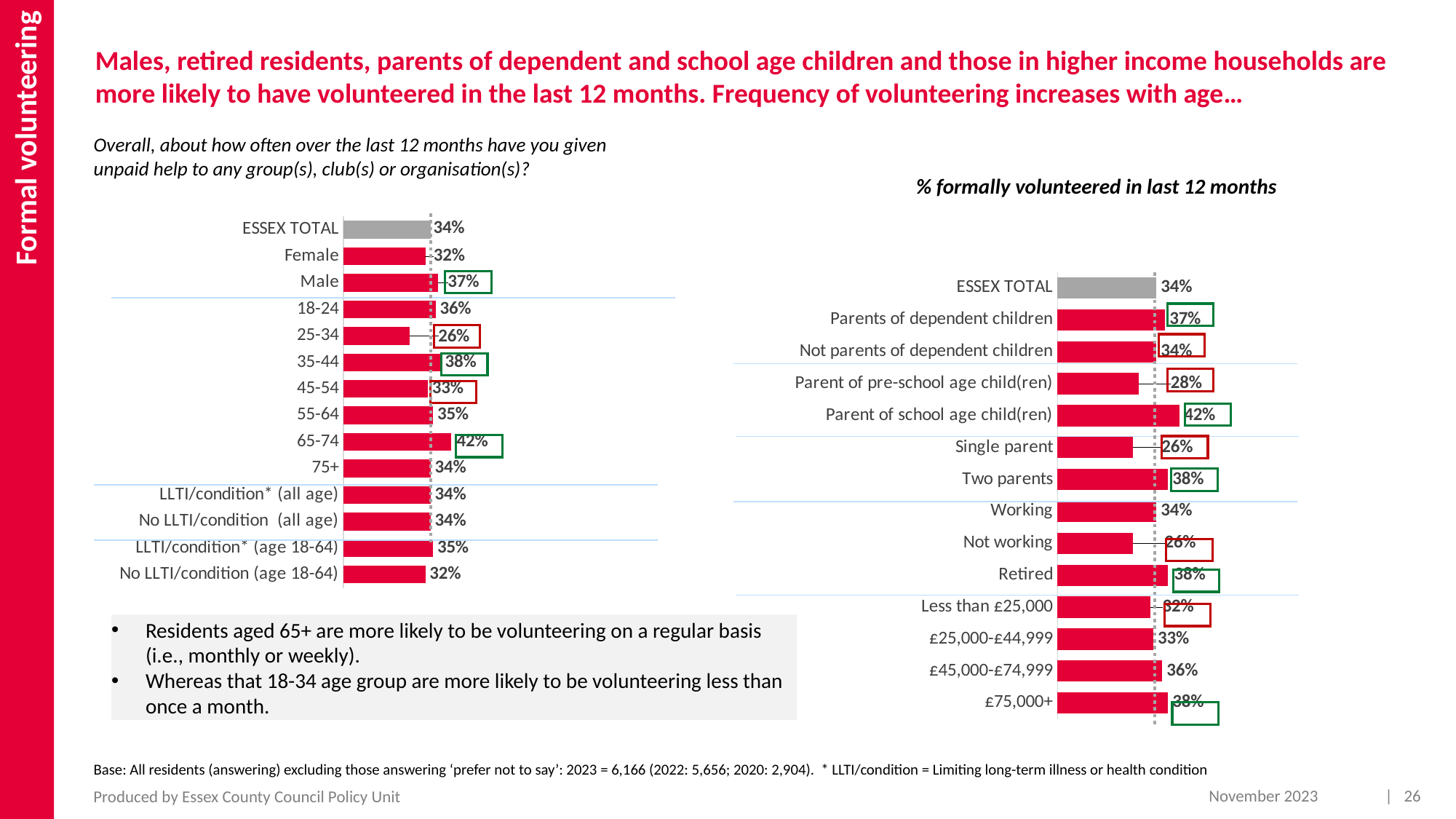
On the right chart, which category has the lowest value among Parent of pre-school age child(ren), Single parent and Two parents? Single parent On the right chart, what is the difference between the values for Two parents and Single parent? 12% On the right chart, what is the value for Parent of school age child(ren)? 42% On the left chart, what is the value for Male? 37% On the left chart, what is the value for No LLTI/condition (age 18-64)? 32% On the right chart, what is the value for Single parent? 26% On the left chart, which age group has the highest value? 65-74 What type of chart is the right chart? Bar chart On the left chart, which is larger, the value for 35-44 or the value for 45-54? 35-44 What is the title of the right chart? % formally volunteered in last 12 months On the left chart, what is the value for the 25-34 age group? 26% On the left chart, what is the difference between the values for Male and Female? 5%